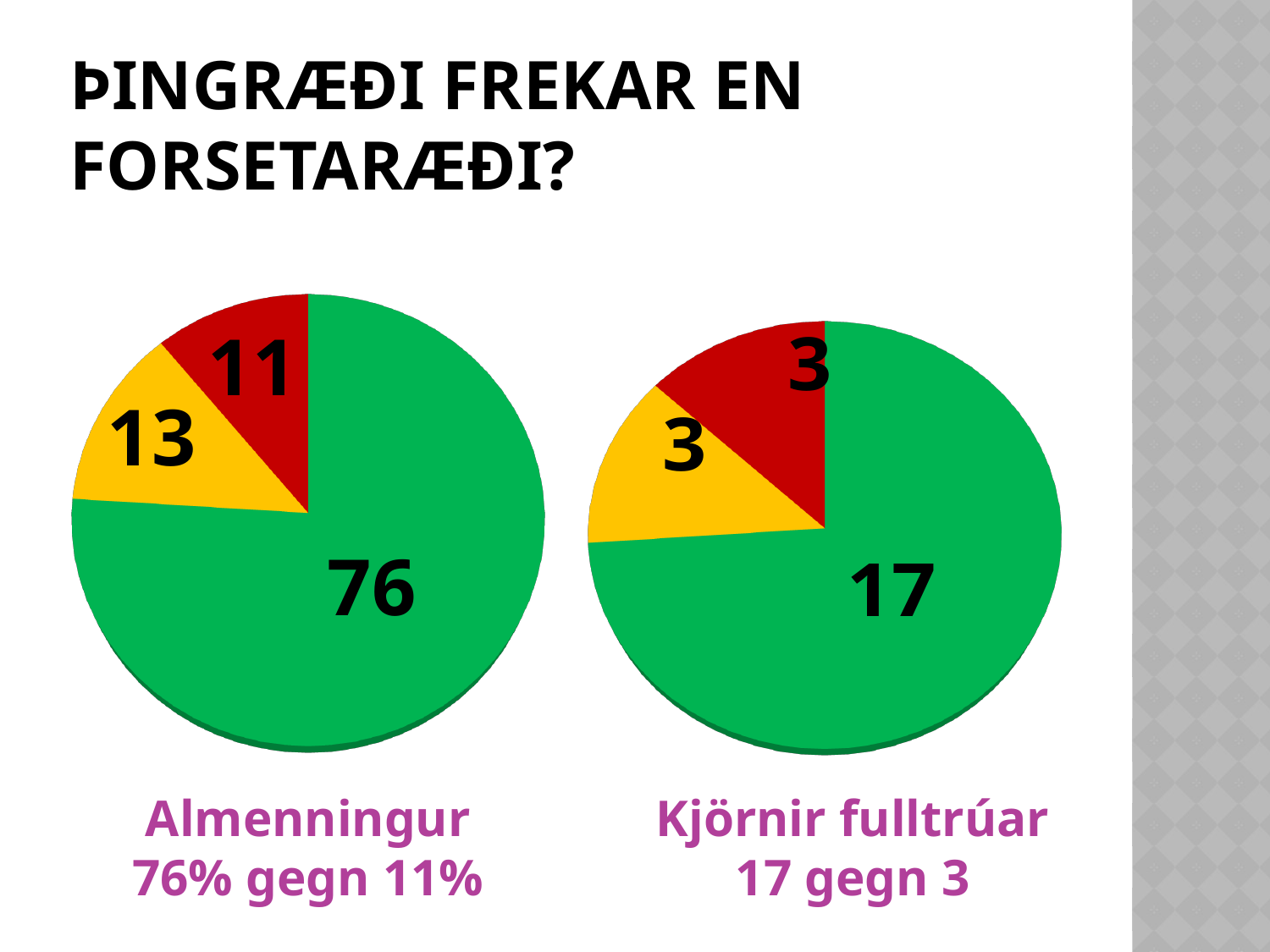
In the Almenningur pie chart, what value is shown for the yellow slice? 13 In the Almenningur pie chart, what value is shown for the red slice? 11 In the Kjörnir fulltrúar pie chart, what is the difference between the green slice and the yellow slice? 14 In the Almenningur pie chart, what is the difference between the green slice and the red slice? 65 In the Kjörnir fulltrúar pie chart, what value is shown for the red slice? 3 How many slices does the Kjörnir fulltrúar pie chart have? 3 In the Almenningur pie chart, which slice is the smallest? Red (11) In the Almenningur pie chart, what value is shown for the green slice? 76 What kind of charts are shown on the slide? Pie charts In the Kjörnir fulltrúar pie chart, what value is shown for the green slice? 17 In the Kjörnir fulltrúar pie chart, what is the total of all slices? 23 In the Almenningur pie chart, which slice is the largest? Green (76)